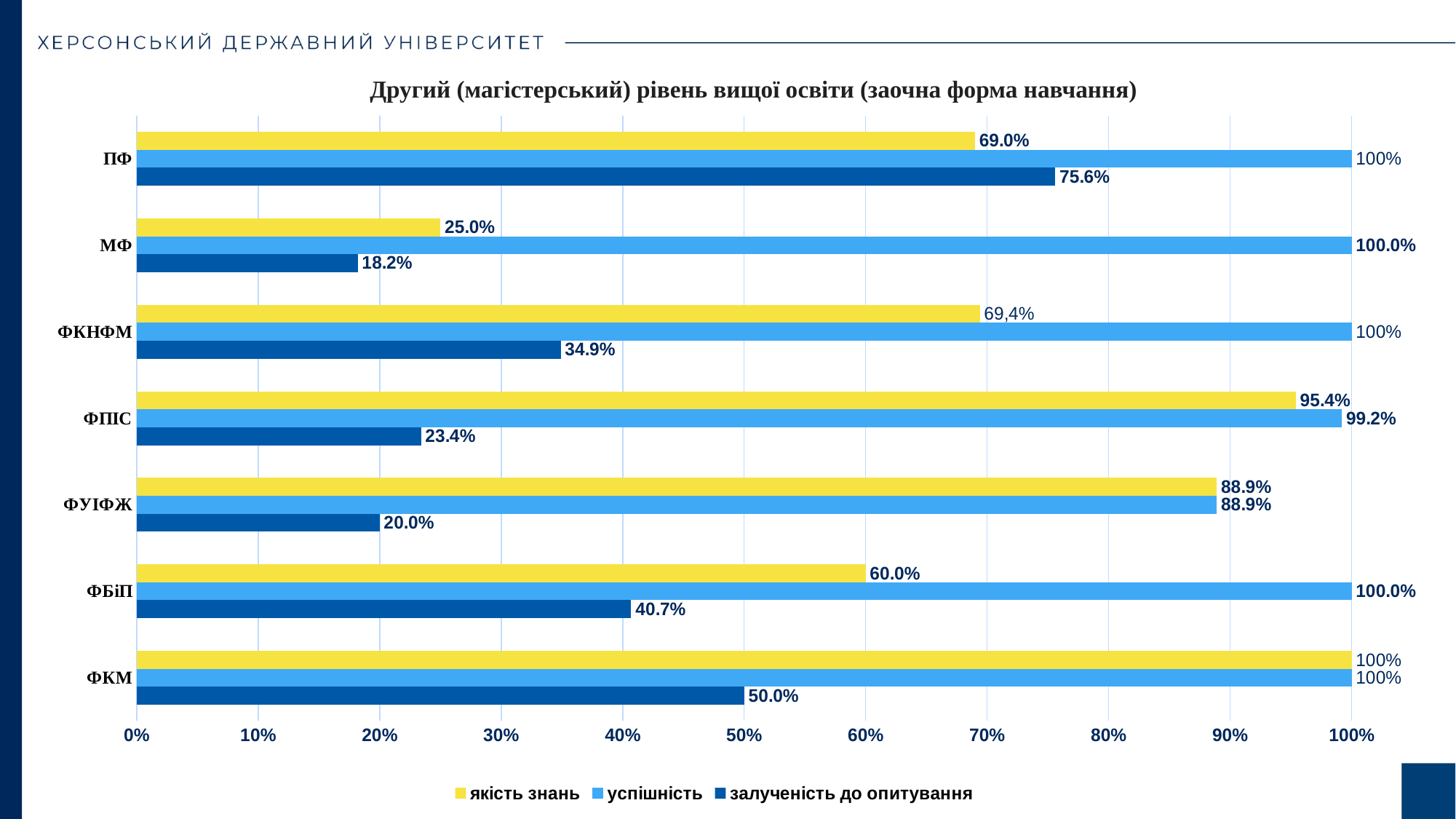
What is the value of залученість до опитування for ПФ? 75.6% What is the difference between якість знань for ФПІС and якість знань for ФБіП? 35.4% Which series is shown in yellow in the legend? якість знань What is the value of успішність for ФПІС? 99.2% What kind of chart is shown on the slide? Bar chart Which category has the lowest value for якість знань? МФ What is the value of залученість до опитування for ФБіП? 40.7% How many categories are shown on the chart? 7 Which is larger: залученість до опитування for ФКМ or залученість до опитування for ФКНФМ? ФКМ Which category has the highest value for залученість до опитування? ПФ What is the value of якість знань for МФ? 25.0% How many series does the legend list? 3